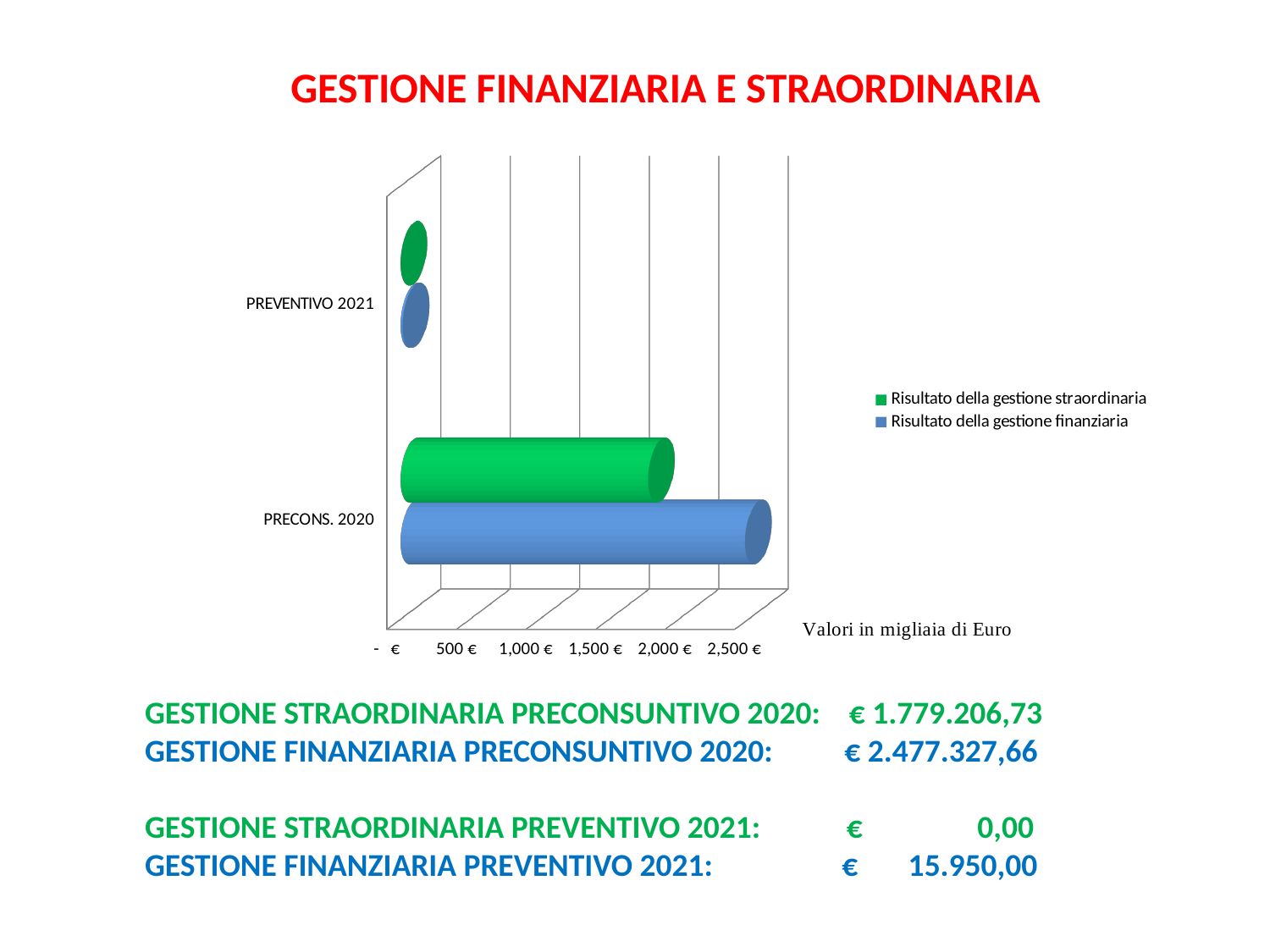
Is the value of 'Risultato della gestione finanziaria' for PREVENTIVO 2021 greater or less than 500 €? less According to the text below the chart, what is the value of GESTIONE FINANZIARIA PRECONSUNTIVO 2020? € 2.477.327,66 What is the title of the slide above the chart? GESTIONE FINANZIARIA E STRAORDINARIA Is the value of 'Risultato della gestione straordinaria' for PRECONS. 2020 greater or less than 2,000 €? less What kind of chart is shown on the slide? bar chart How many series does the chart legend list? 2 For PRECONS. 2020, which series has the larger value: 'Risultato della gestione finanziaria' or 'Risultato della gestione straordinaria'? Risultato della gestione finanziaria According to the text below the chart, what is the value of GESTIONE STRAORDINARIA PREVENTIVO 2021? € 0,00 Is the value of 'Risultato della gestione finanziaria' for PRECONS. 2020 greater or less than 2,000 €? greater Which colour represents 'Risultato della gestione finanziaria' in the chart? blue How many categories are shown on the chart's vertical axis? 2 Which category has the highest value for 'Risultato della gestione finanziaria'? PRECONS. 2020